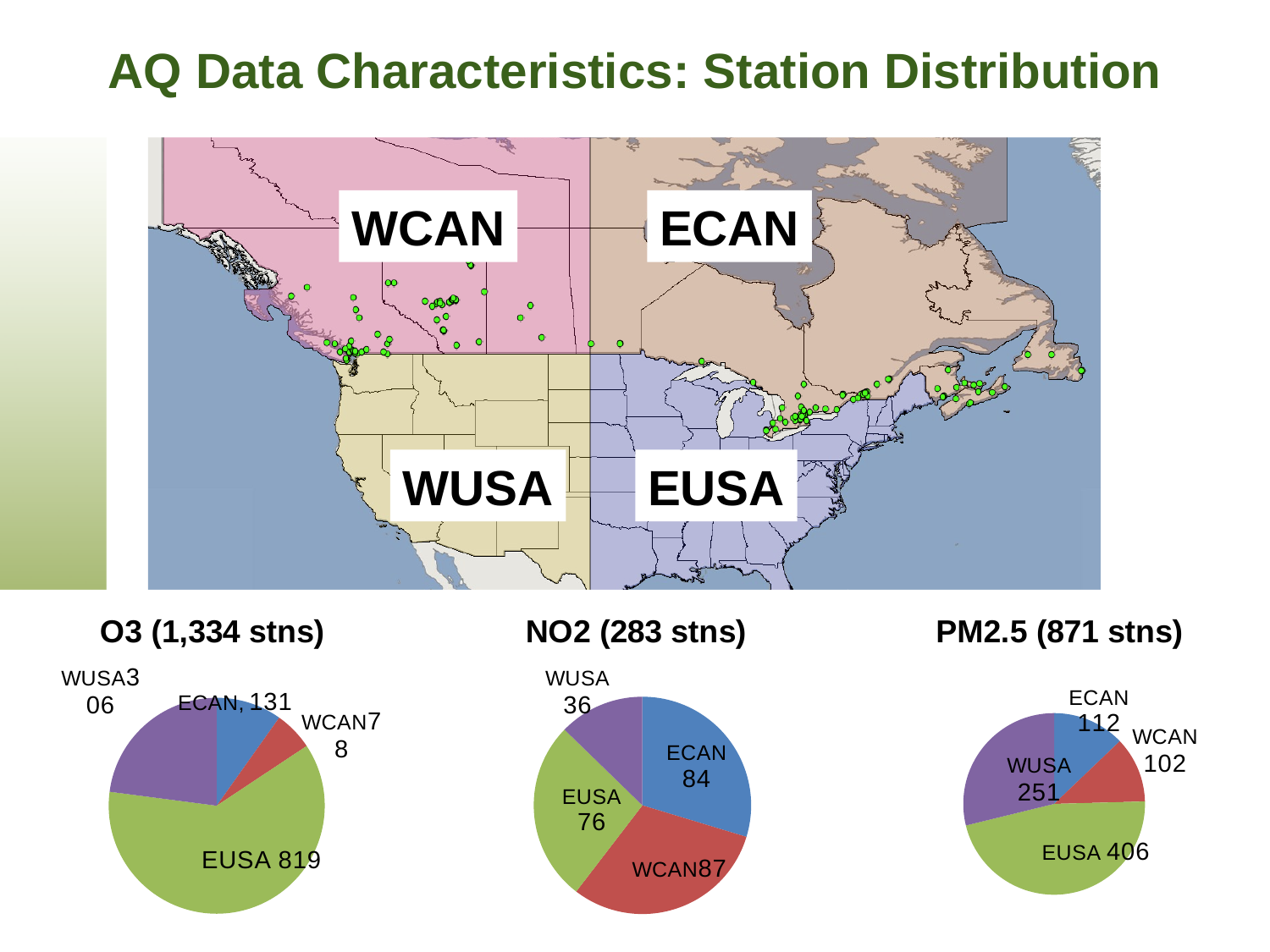
In the O3 (1,334 stns) pie chart, how many stations does EUSA have? 819 In the PM2.5 (871 stns) pie chart, what is the difference between the EUSA and WUSA values? 155 How many pie charts are shown on the slide? 3 In the NO2 (283 stns) pie chart, which region has the largest value? WCAN In the NO2 (283 stns) pie chart, what is the value for WUSA? 36 How many slices does the PM2.5 (871 stns) pie chart have? 4 In the O3 (1,334 stns) pie chart, which region has the smallest slice? WCAN In the PM2.5 (871 stns) pie chart, which region has the largest slice? EUSA What type of chart is used for the O3 (1,334 stns) data? Pie chart In the NO2 (283 stns) pie chart, which is larger, the ECAN value or the EUSA value? ECAN In the PM2.5 (871 stns) pie chart, what is the value for WCAN? 102 In the O3 (1,334 stns) pie chart, what is the difference between the ECAN and WCAN values? 53